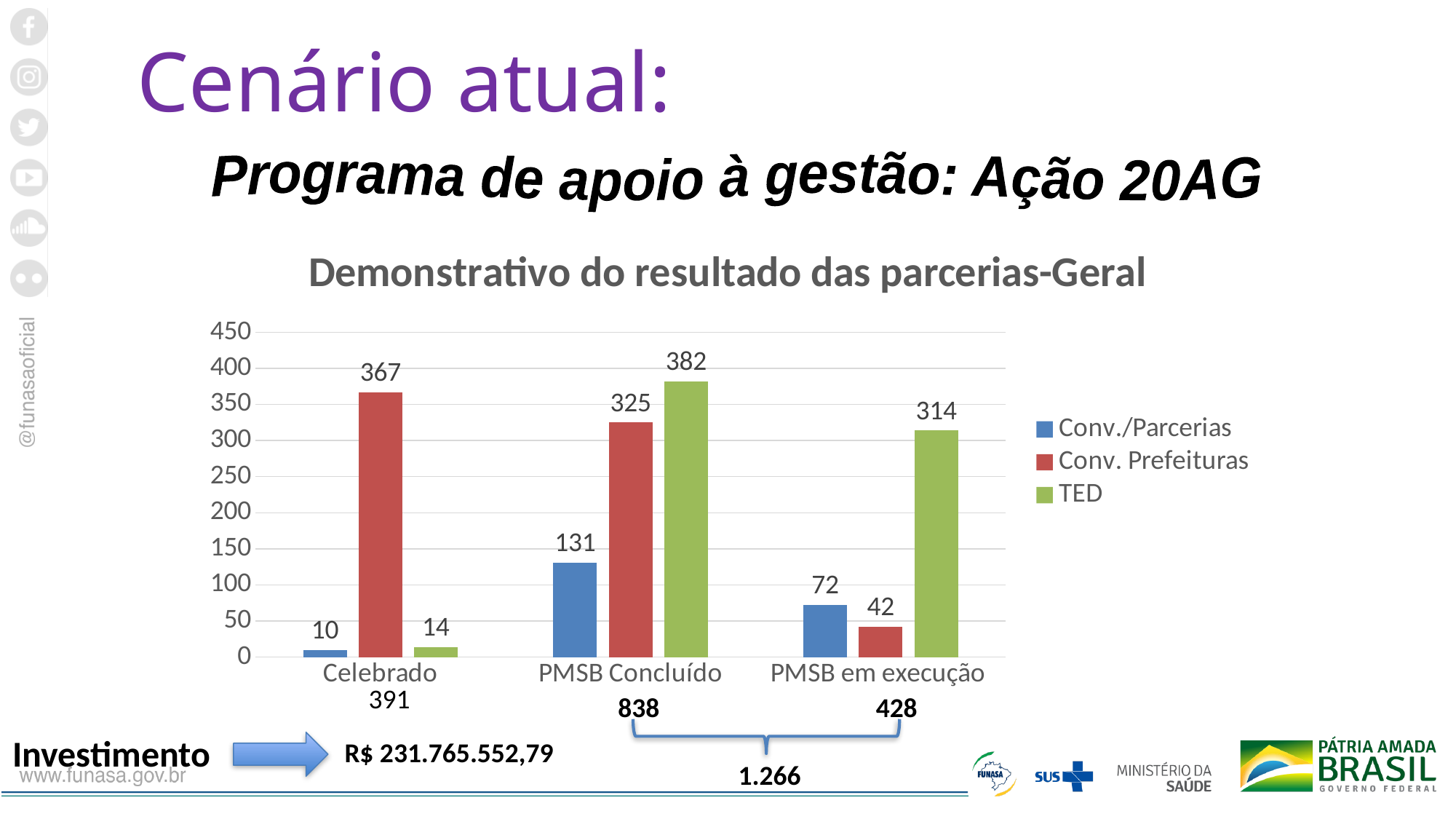
What is the value of TED for PMSB Concluído? 382 What kind of chart is shown on the slide? bar chart What is the value of Conv. Prefeituras for Celebrado? 367 Which is larger for PMSB em execução: Conv./Parcerias or Conv. Prefeituras? Conv./Parcerias Is the TED value for PMSB em execução greater or less than 300? greater How many categories are shown on the x axis? 3 Which category has the highest TED value? PMSB Concluído What is the title of the chart? Demonstrativo do resultado das parcerias-Geral Which category has the lowest Conv./Parcerias value? Celebrado What is the difference between the Conv. Prefeituras values for Celebrado and PMSB Concluído? 42 How many series does the legend list? 3 What is the value of Conv./Parcerias for PMSB em execução? 72